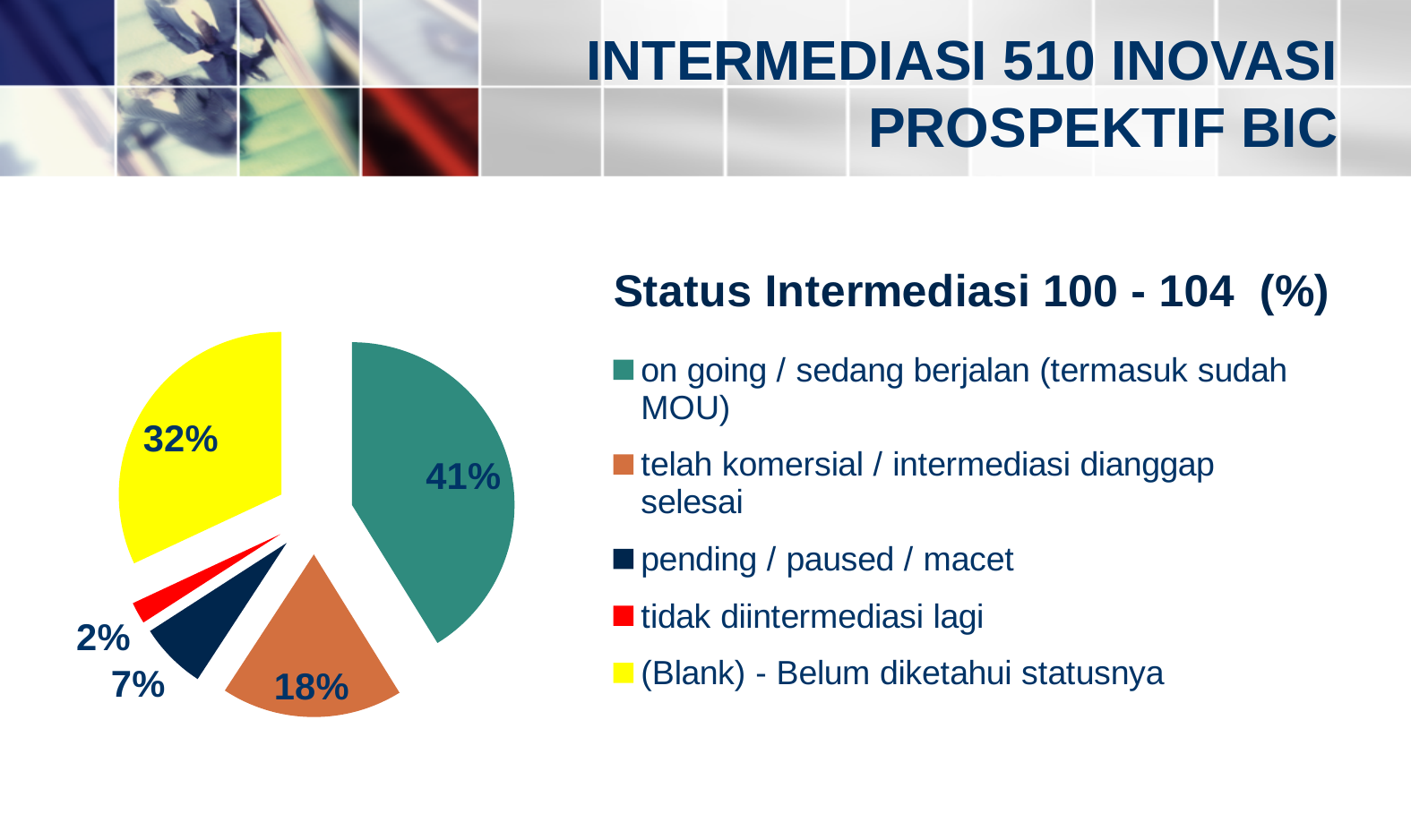
What share of the pie is 'pending / paused / macet'? 7% Which category has the largest share of the pie? on going / sedang berjalan (termasuk sudah MOU) What is the title of the chart? Status Intermediasi 100 - 104 (%) What share of the pie is '(Blank) - Belum diketahui statusnya'? 32% Which category has the smallest share of the pie? tidak diintermediasi lagi What share of the pie is 'tidak diintermediasi lagi'? 2% Which is larger: the share for 'telah komersial / intermediasi dianggap selesai' or the share for 'pending / paused / macet'? telah komersial / intermediasi dianggap selesai What is the difference in percentage points between the 'on going / sedang berjalan' slice and the '(Blank) - Belum diketahui statusnya' slice? 9 percentage points How many categories does the legend list? 5 What kind of chart is shown on the slide? Pie chart